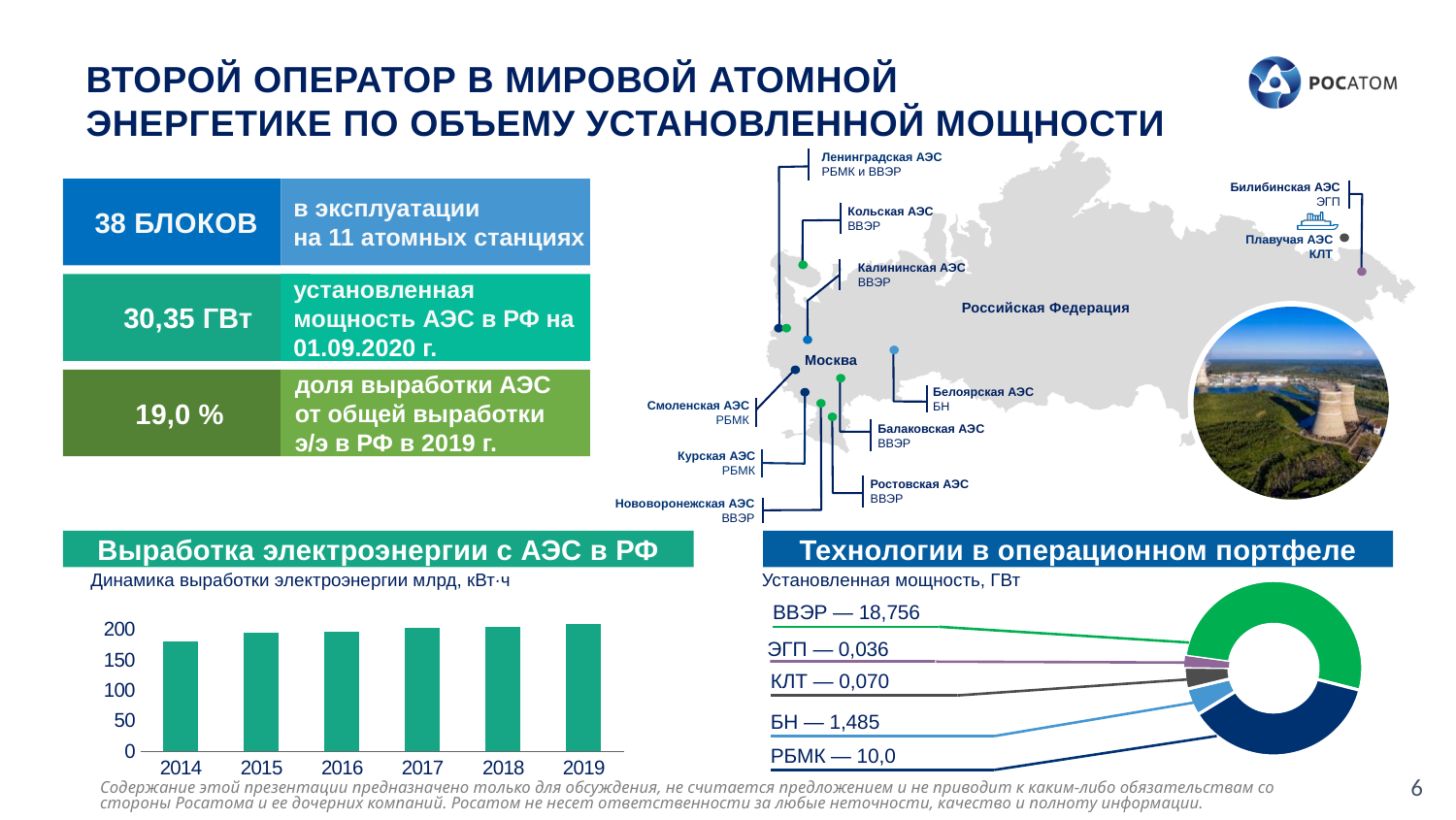
In the chart 'Технологии в операционном портфеле', what is the installed capacity for ВВЭР? 18,756 In the chart 'Технологии в операционном портфеле', what is the installed capacity for БН? 1,485 In the chart 'Выработка электроэнергии с АЭС в РФ', what kind of chart is shown? bar chart In the chart 'Технологии в операционном портфеле', how many technologies are listed? 5 In the chart 'Технологии в операционном портфеле', which technology has the largest installed capacity? ВВЭР In the chart 'Технологии в операционном портфеле', which technology has the smallest installed capacity? ЭГП In the chart 'Выработка электроэнергии с АЭС в РФ', is the value for 2019 greater or less than 200? greater In the chart 'Выработка электроэнергии с АЭС в РФ', is the value for 2014 greater or less than 200? less In the chart 'Выработка электроэнергии с АЭС в РФ', how many years are plotted on the x axis? 6 In the chart 'Технологии в операционном портфеле', what is the difference between the ВВЭР and РБМК values? 8,756 In the chart 'Выработка электроэнергии с АЭС в РФ', which year has the lowest value? 2014 In the chart 'Выработка электроэнергии с АЭС в РФ', do the values generally rise or fall from 2014 to 2019? rise